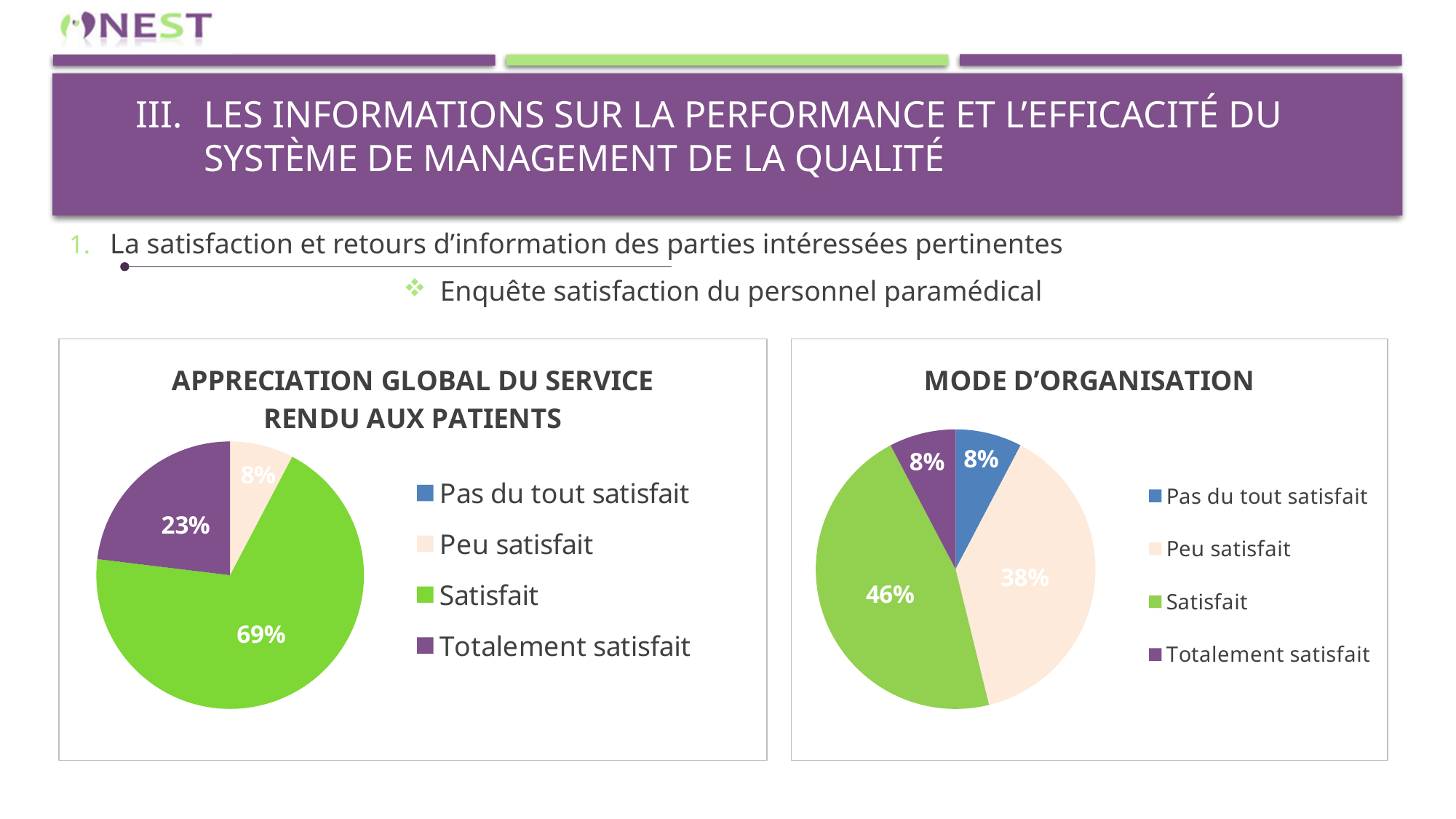
In the 'APPRECIATION GLOBAL DU SERVICE RENDU AUX PATIENTS' chart, what share is 'Satisfait'? 69% In the 'MODE D'ORGANISATION' chart, which is larger, 'Satisfait' or 'Peu satisfait'? Satisfait In the 'APPRECIATION GLOBAL DU SERVICE RENDU AUX PATIENTS' chart, which category has the largest slice? Satisfait In the 'MODE D'ORGANISATION' chart, what share is 'Satisfait'? 46% In the 'APPRECIATION GLOBAL DU SERVICE RENDU AUX PATIENTS' chart, what is the difference between 'Satisfait' and 'Totalement satisfait'? 46% In the 'APPRECIATION GLOBAL DU SERVICE RENDU AUX PATIENTS' chart, what share is 'Totalement satisfait'? 23% What kind of chart is the 'APPRECIATION GLOBAL DU SERVICE RENDU AUX PATIENTS' chart? Pie chart In the 'MODE D'ORGANISATION' chart, what share is 'Peu satisfait'? 38% How many entries does the legend of the 'MODE D'ORGANISATION' chart list? 4 In the 'MODE D'ORGANISATION' chart, what share is 'Pas du tout satisfait'? 8% In the 'MODE D'ORGANISATION' chart, what colour is the 'Satisfait' slice? Green In the 'APPRECIATION GLOBAL DU SERVICE RENDU AUX PATIENTS' chart, what share is 'Peu satisfait'? 8%